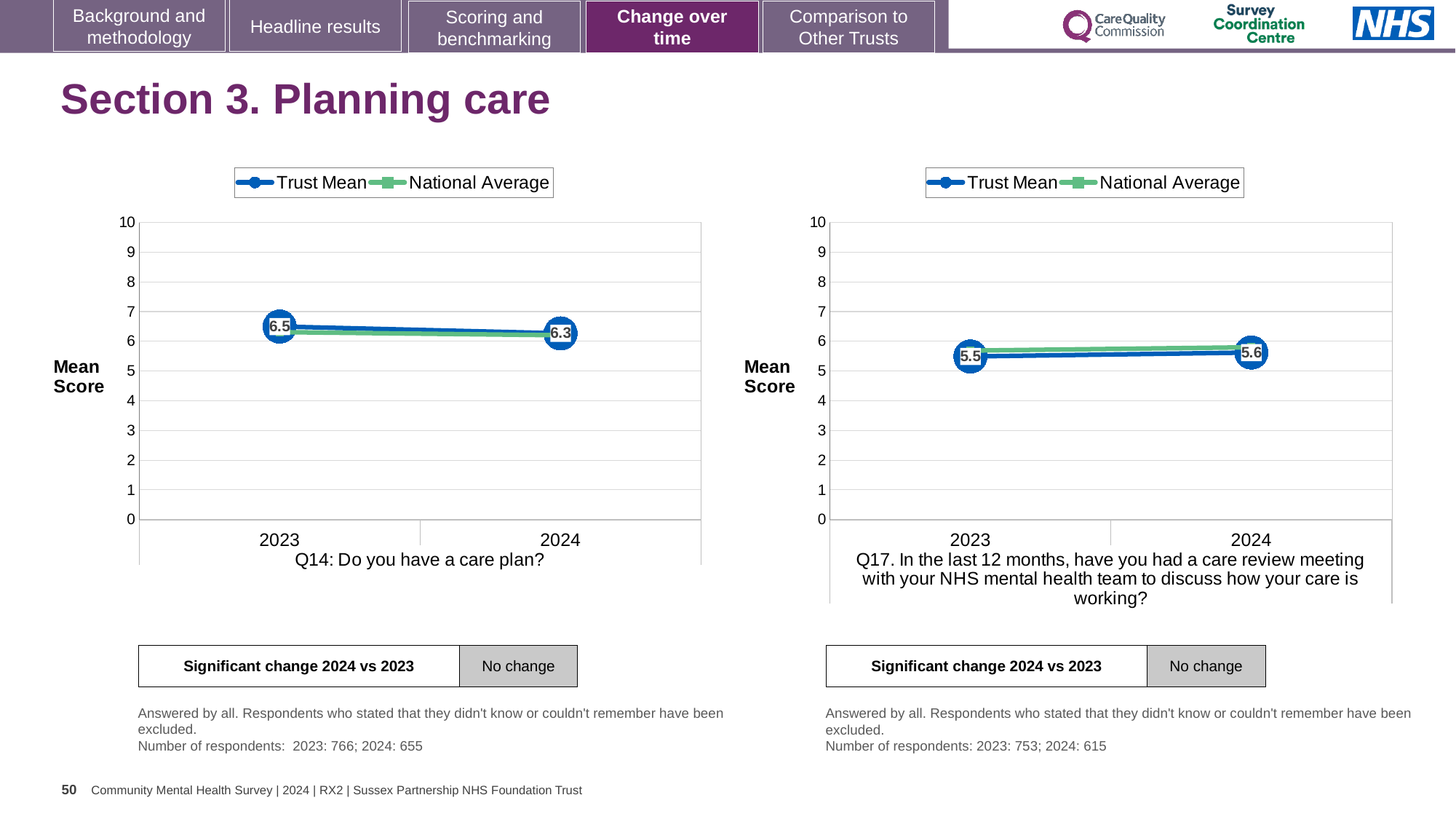
In the right chart (Q17, care review meeting), what is the Trust Mean score for 2024? 5.6 In the right chart (Q17, care review meeting), what is the Trust Mean score for 2023? 5.5 How many series does the legend of the right chart (Q17) list? 2 How many years are plotted on the x axis of the left chart (Q14)? 2 What kind of chart is the left chart (Q14)? line chart In the right chart (Q17), does the Trust Mean rise or fall from 2023 to 2024? rise In the left chart (Q14: Do you have a care plan?), what is the Trust Mean score for 2024? 6.3 In the left chart (Q14: Do you have a care plan?), what is the Trust Mean score for 2023? 6.5 In the left chart (Q14), does the Trust Mean rise or fall from 2023 to 2024? fall In the right chart (Q17), is the National Average value for 2023 greater or less than 7? less In the right chart (Q17), what is the difference between the Trust Mean for 2024 and 2023? 0.1 In the left chart (Q14), by how much did the Trust Mean change from 2023 to 2024? 0.2